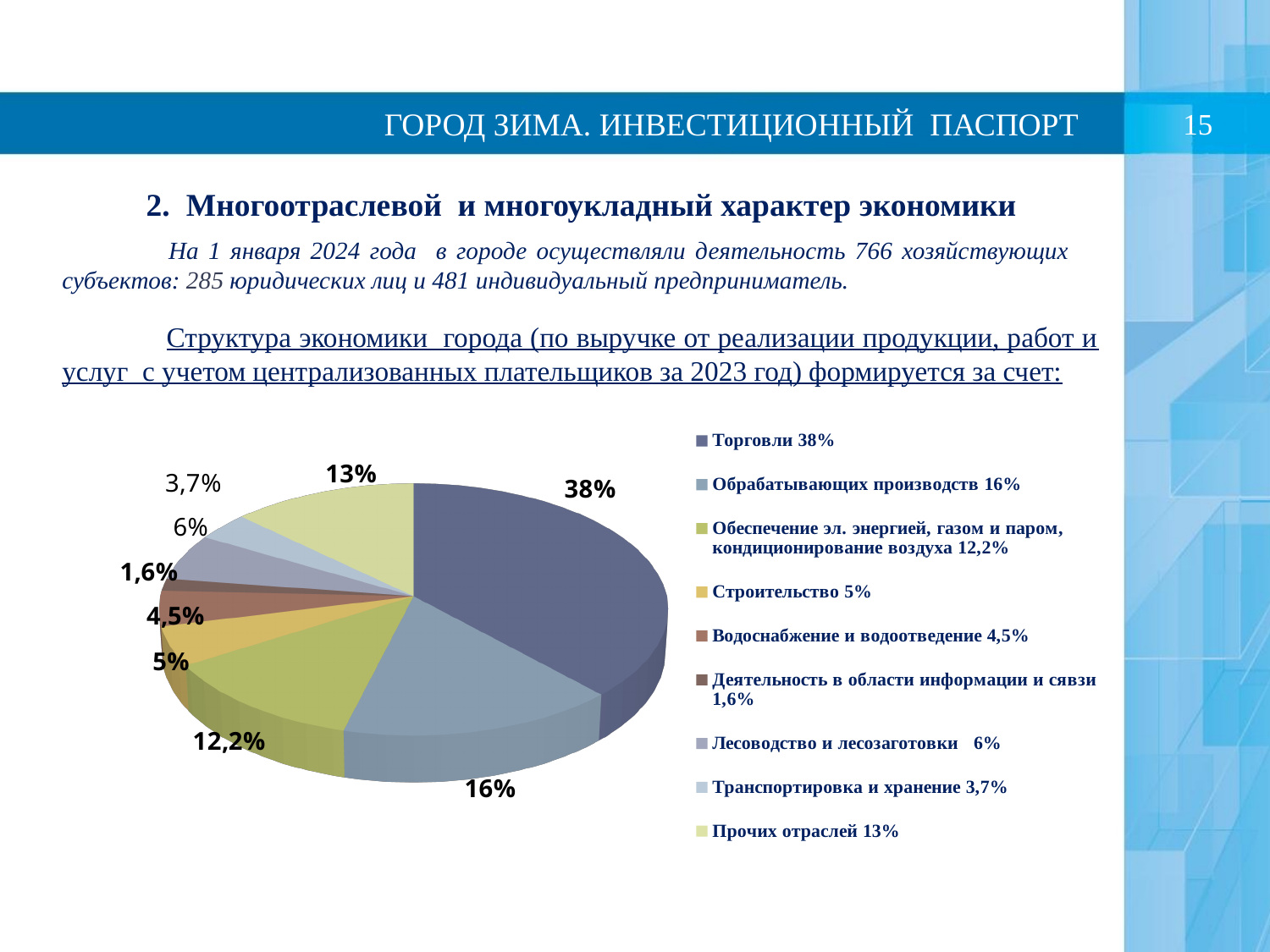
What is the value shown for Обрабатывающих производств? 16% Which category has the largest slice of the pie? Торговли What is the value shown for Водоснабжение и водоотведение? 4,5% What is the value shown for Строительство? 5% What is the value shown for Прочих отраслей? 13% Which category has the smallest slice of the pie? Деятельность в области информации и связи What is the difference between the shares of Торговли and Обрабатывающих производств? 22% What is the value shown for Обеспечение эл. энергией, газом и паром, кондиционирование воздуха? 12,2% What kind of chart is shown on the slide? Pie chart How many slices does the pie chart have? 9 Which is larger: the share of Лесоводство и лесозаготовки or the share of Транспортировка и хранение? Лесоводство и лесозаготовки What share of the pie does Торговли take? 38%